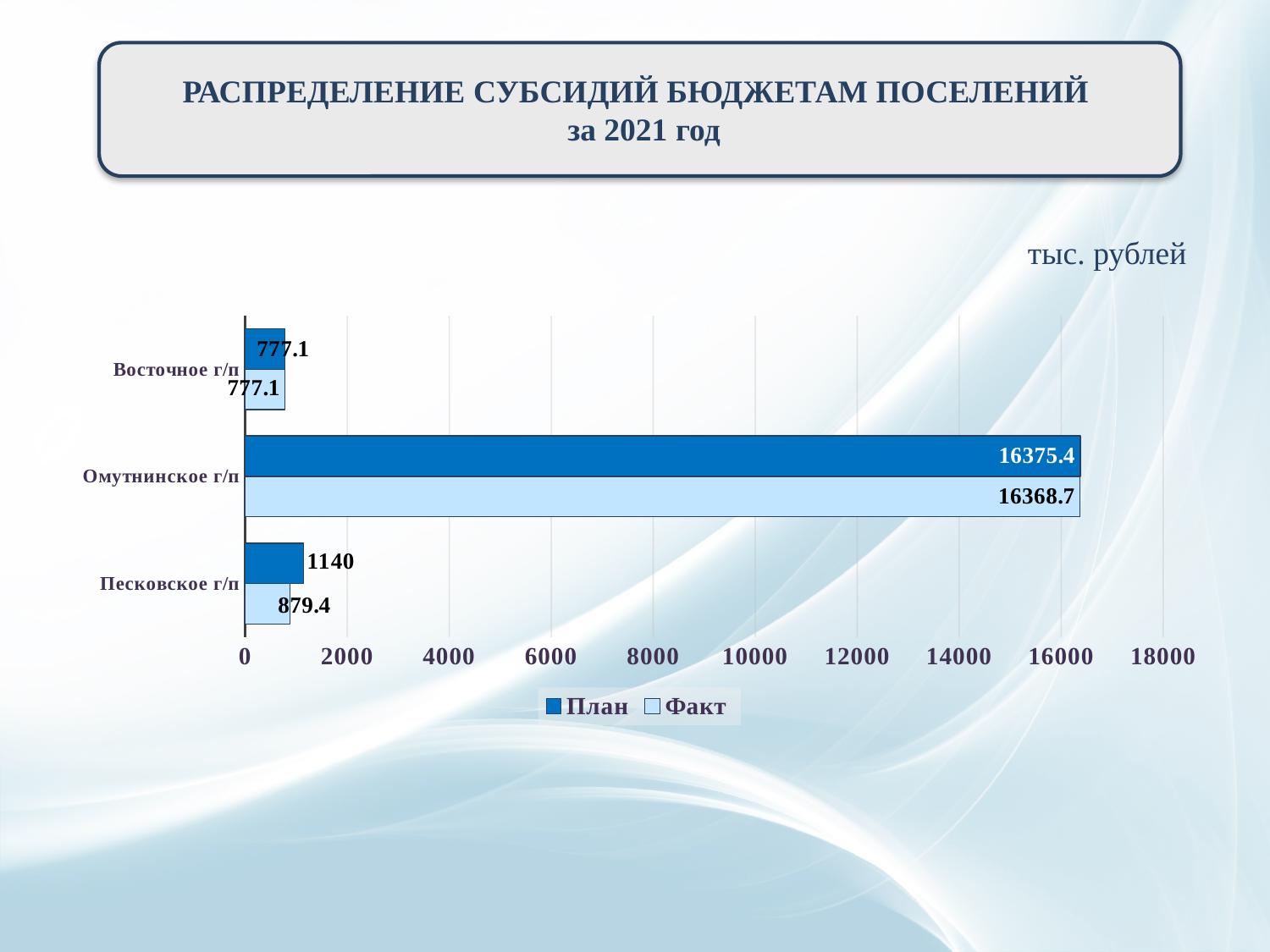
What is the План value for Омутнинское г/п? 16375.4 What is the difference between the План and Факт values for Омутнинское г/п? 6.7 Which settlement has the lowest План value? Восточное г/п What kind of chart is shown on the slide? Bar chart What is the Факт value for Восточное г/п? 777.1 How many series does the legend list? 2 What is the План value for Песковское г/п? 1140 Which settlement has the highest Факт value? Омутнинское г/п What is the Факт value for Песковское г/п? 879.4 What is the difference between the План and Факт values for Песковское г/п? 260.6 Which is larger for Песковское г/п, the План value or the Факт value? План How many settlements are shown on the chart? 3